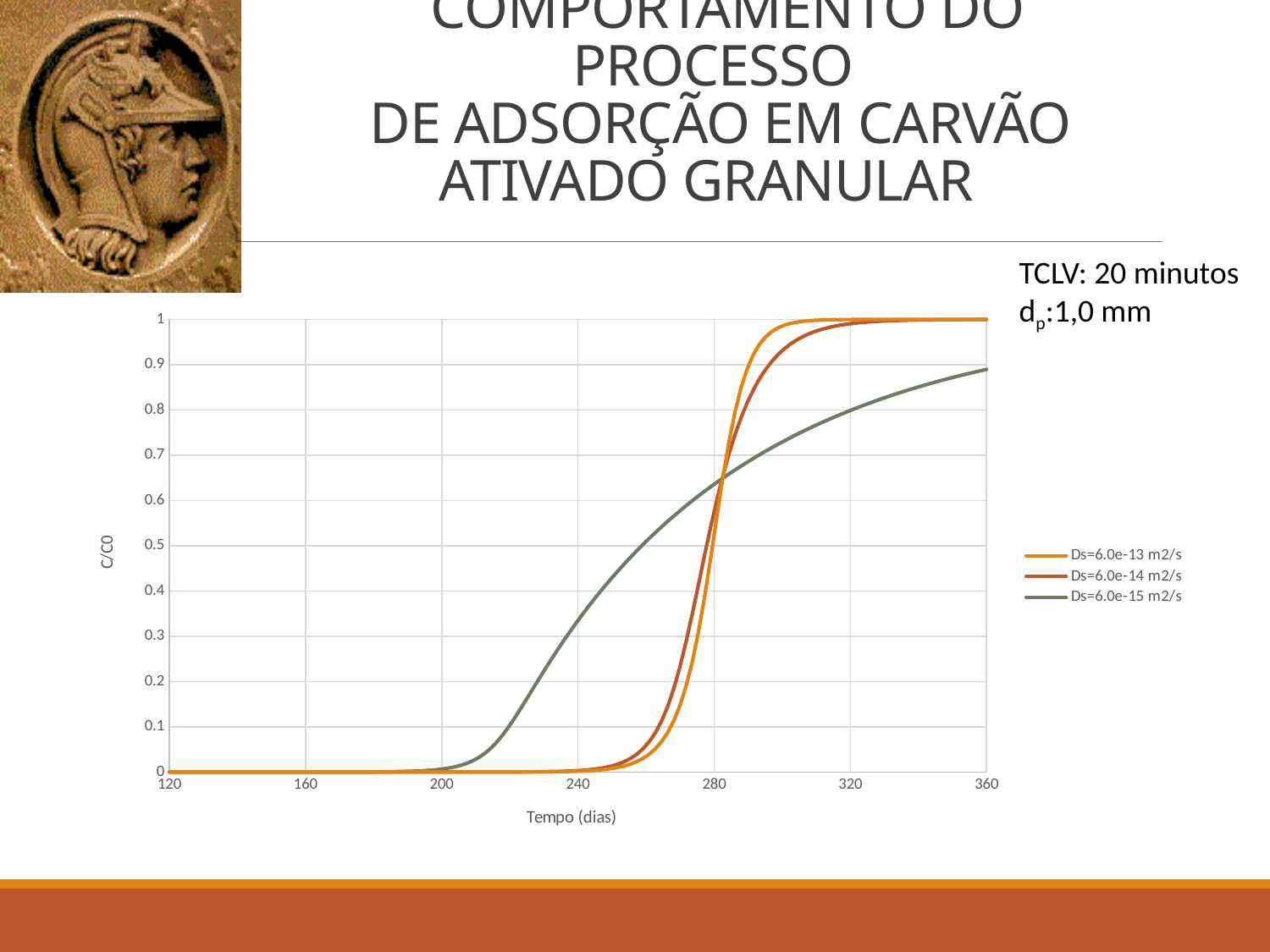
Is the value of the Ds=6.0e-13 m2/s series at 320 days greater or less than 0.9? greater How many series does the legend list? 3 Is the value of the Ds=6.0e-15 m2/s series at 360 days greater or less than 0.8? greater What is the title of the y axis of the chart? C/C0 Is the value of the Ds=6.0e-13 m2/s series at 260 days greater or less than 0.1? less What kind of chart is shown on the slide? Line chart Do the values of the Ds=6.0e-15 m2/s series rise or fall as time increases along the x axis? Rise At 320 days, which series has the higher C/C0 value: Ds=6.0e-13 m2/s or Ds=6.0e-15 m2/s? Ds=6.0e-13 m2/s At 240 days, which series has the higher C/C0 value: Ds=6.0e-13 m2/s or Ds=6.0e-15 m2/s? Ds=6.0e-15 m2/s How many tick labels are shown on the x axis of the chart? 7 What is the title of the x axis of the chart? Tempo (dias)